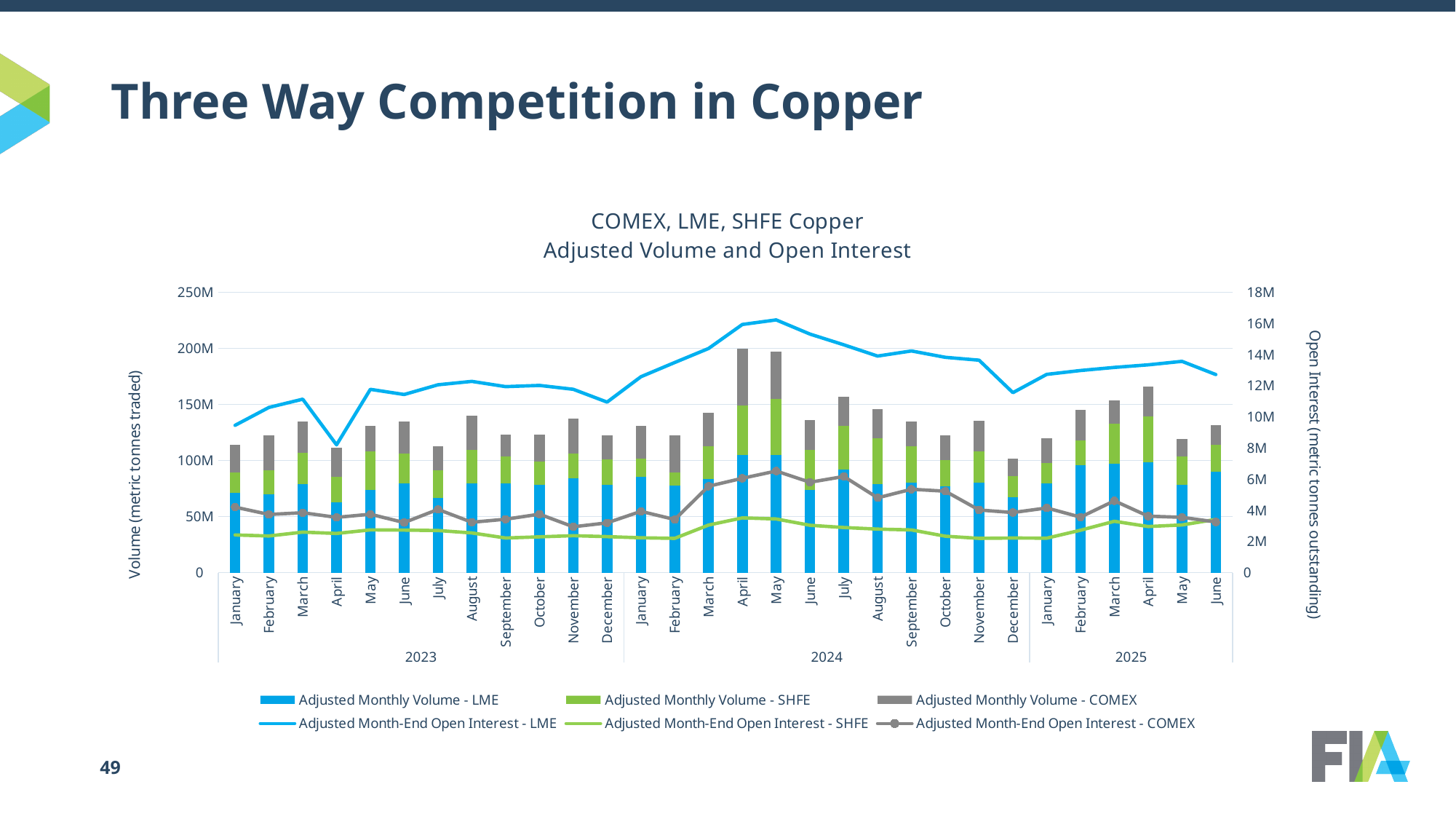
In which month does the Adjusted Month-End Open Interest - LME line reach its lowest point? April 2023 Is the Adjusted Month-End Open Interest - LME for May 2024 greater or less than 14M? greater Is the total stacked volume for December 2024 greater or less than 150M? less Which month has the shortest stacked volume bar? December 2024 What kind of chart is shown on the slide? A combination of a stacked bar chart and a line chart How many series does the legend list? 6 What is the label of the right-hand vertical axis? Open Interest (metric tonnes outstanding) How many months of 2025 are shown in the chart? 6 How many monthly bars are plotted in the chart? 30 Which is larger, the total stacked volume for April 2024 or for December 2024? April 2024 Is the total stacked volume for April 2024 greater or less than 150M? greater Which month has the tallest stacked volume bar? April 2024